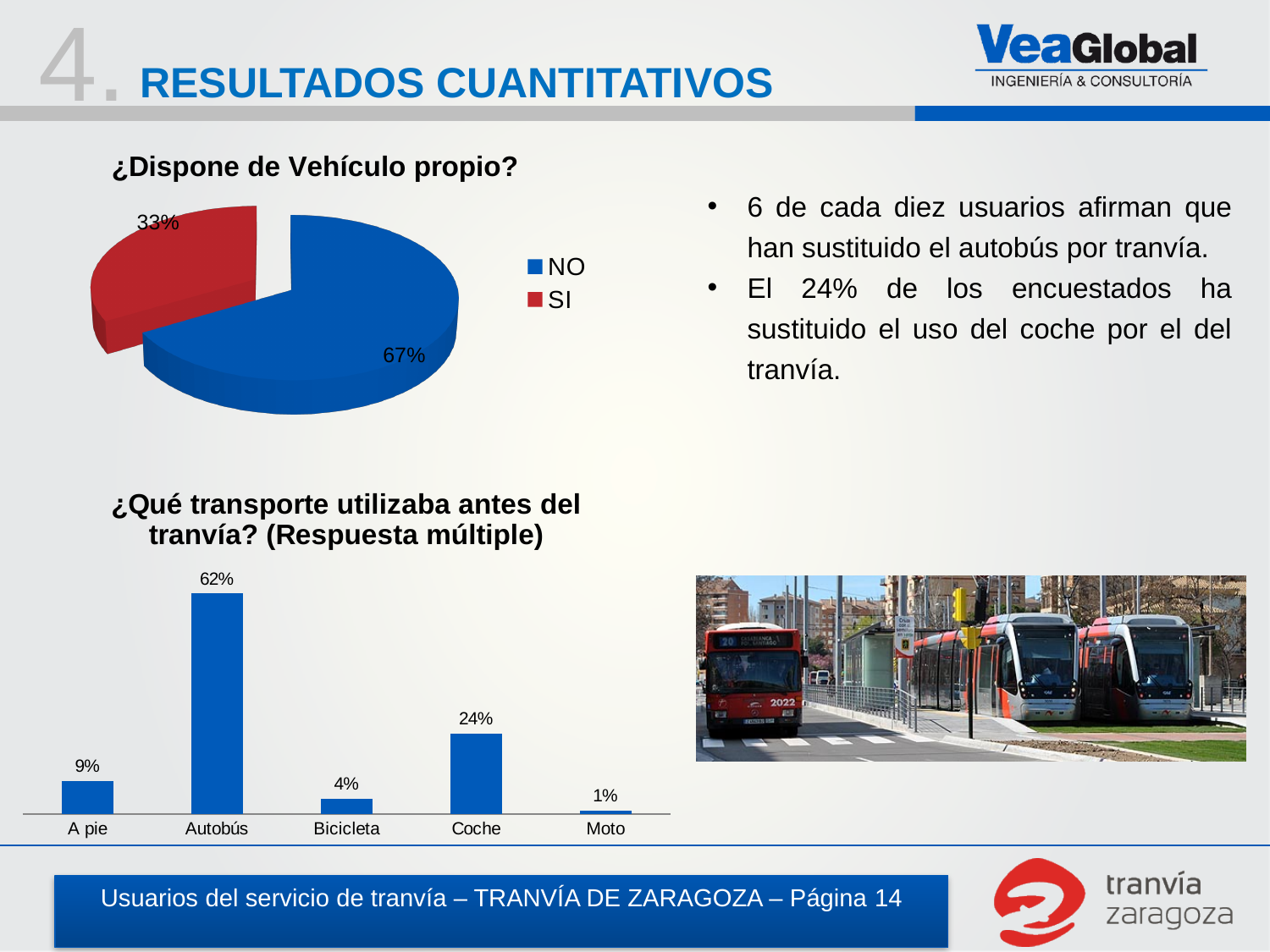
In the chart titled '¿Dispone de Vehículo propio?', what is the difference between the NO and SI shares? 34% In the chart titled '¿Qué transporte utilizaba antes del tranvía? (Respuesta múltiple)', which category has the highest value? Autobús In the chart titled '¿Qué transporte utilizaba antes del tranvía? (Respuesta múltiple)', which category has the lowest value? Moto In the chart titled '¿Dispone de Vehículo propio?', what percentage corresponds to SI? 33% In the chart titled '¿Qué transporte utilizaba antes del tranvía? (Respuesta múltiple)', what is the value for Coche? 24% In the chart titled '¿Qué transporte utilizaba antes del tranvía? (Respuesta múltiple)', what is the value for Autobús? 62% In the chart titled '¿Qué transporte utilizaba antes del tranvía? (Respuesta múltiple)', how many categories are shown? 5 What kind of chart is the one titled '¿Dispone de Vehículo propio?'? pie chart How many entries does the legend of the chart titled '¿Dispone de Vehículo propio?' list? 2 In the chart titled '¿Qué transporte utilizaba antes del tranvía? (Respuesta múltiple)', what is the difference between Autobús and Coche? 38% In the chart titled '¿Qué transporte utilizaba antes del tranvía? (Respuesta múltiple)', which is larger, A pie or Bicicleta? A pie In the chart titled '¿Dispone de Vehículo propio?', what percentage corresponds to NO? 67%